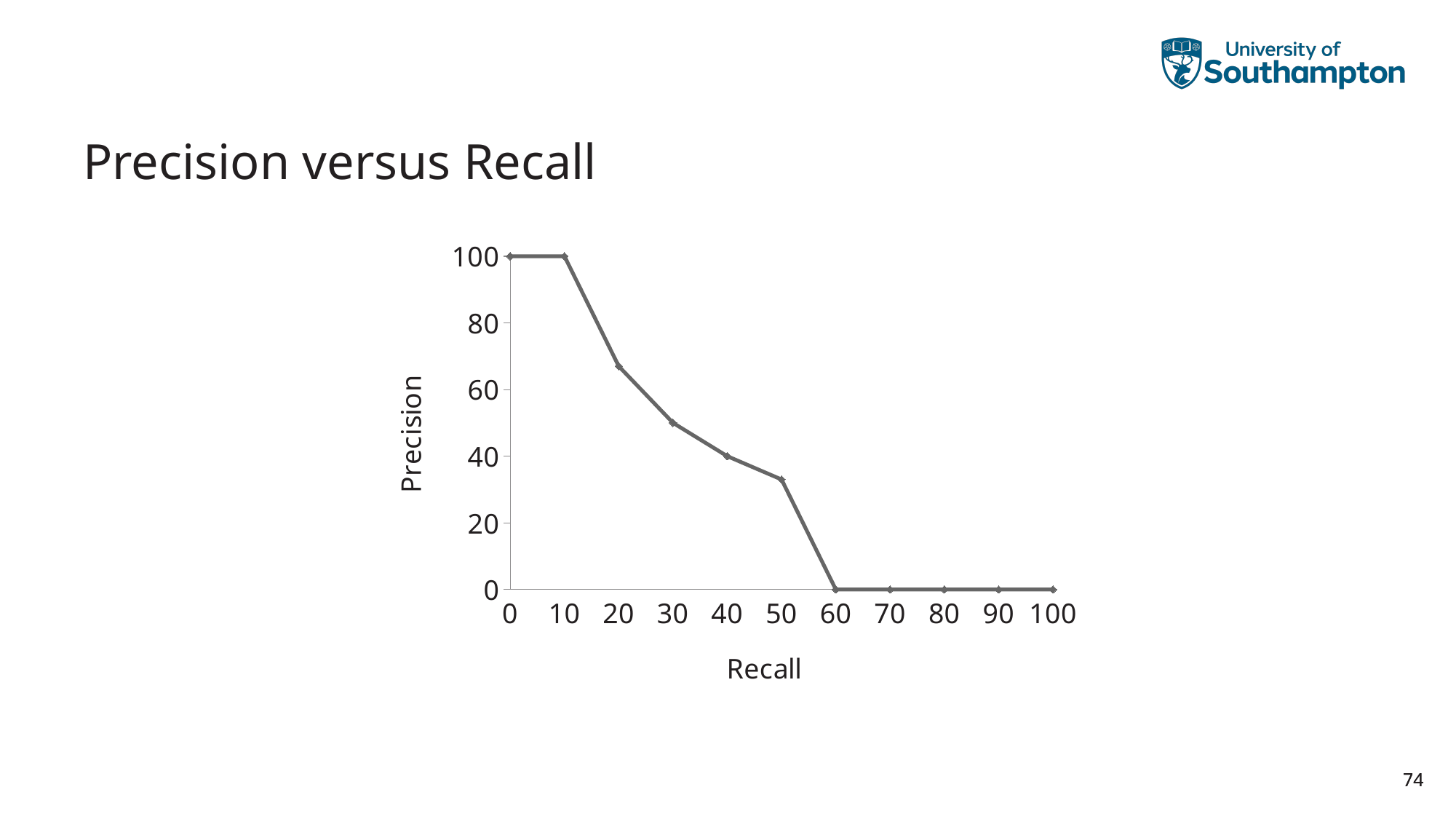
What is the precision value at a recall of 60? 0 How many data points are plotted on the line? 11 What is the precision value at a recall of 0? 100 What is the label of the y axis? Precision Is the precision value at a recall of 20 greater or less than 60? greater What type of chart is shown on the slide? line chart What is the precision value at a recall of 40? 40 Is the precision value at a recall of 50 greater or less than 40? less Do the precision values rise or fall as recall increases along the x axis? fall What is the precision value at a recall of 10? 100